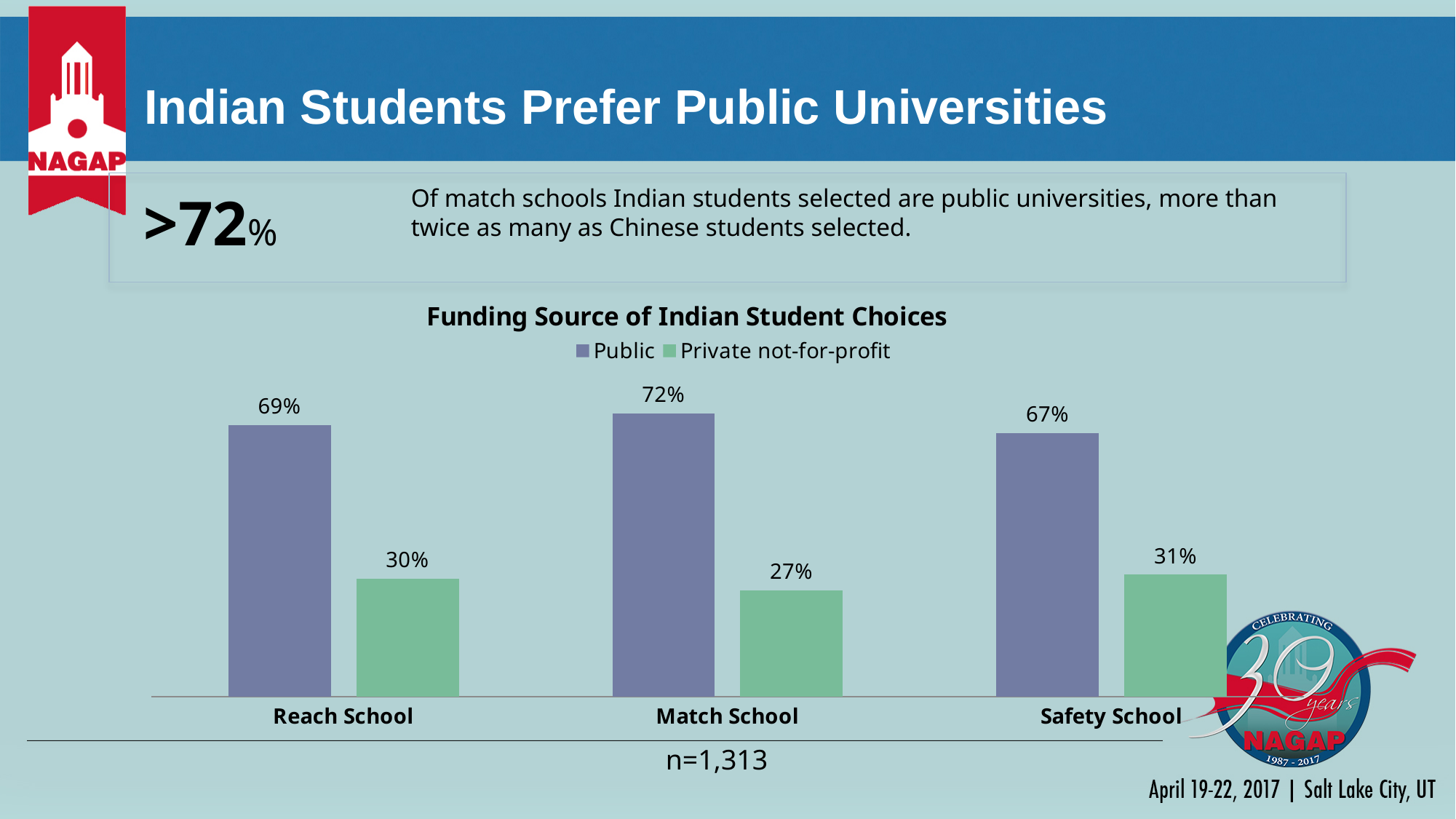
What is the title of the chart? Funding Source of Indian Student Choices Which is larger for Safety School, the Public value or the Private not-for-profit value? Public How many series does the legend list? 2 What kind of chart is shown? Bar chart What is the Private not-for-profit value for Reach School? 30% How many school categories are shown on the x axis? 3 Which school category has the highest Public value? Match School Which school category has the lowest Private not-for-profit value? Match School What is the Private not-for-profit value for Safety School? 31% What is the Public value for Match School? 72% What is the Public value for Safety School? 67% What is the difference between the Public and Private not-for-profit values for Reach School? 39%